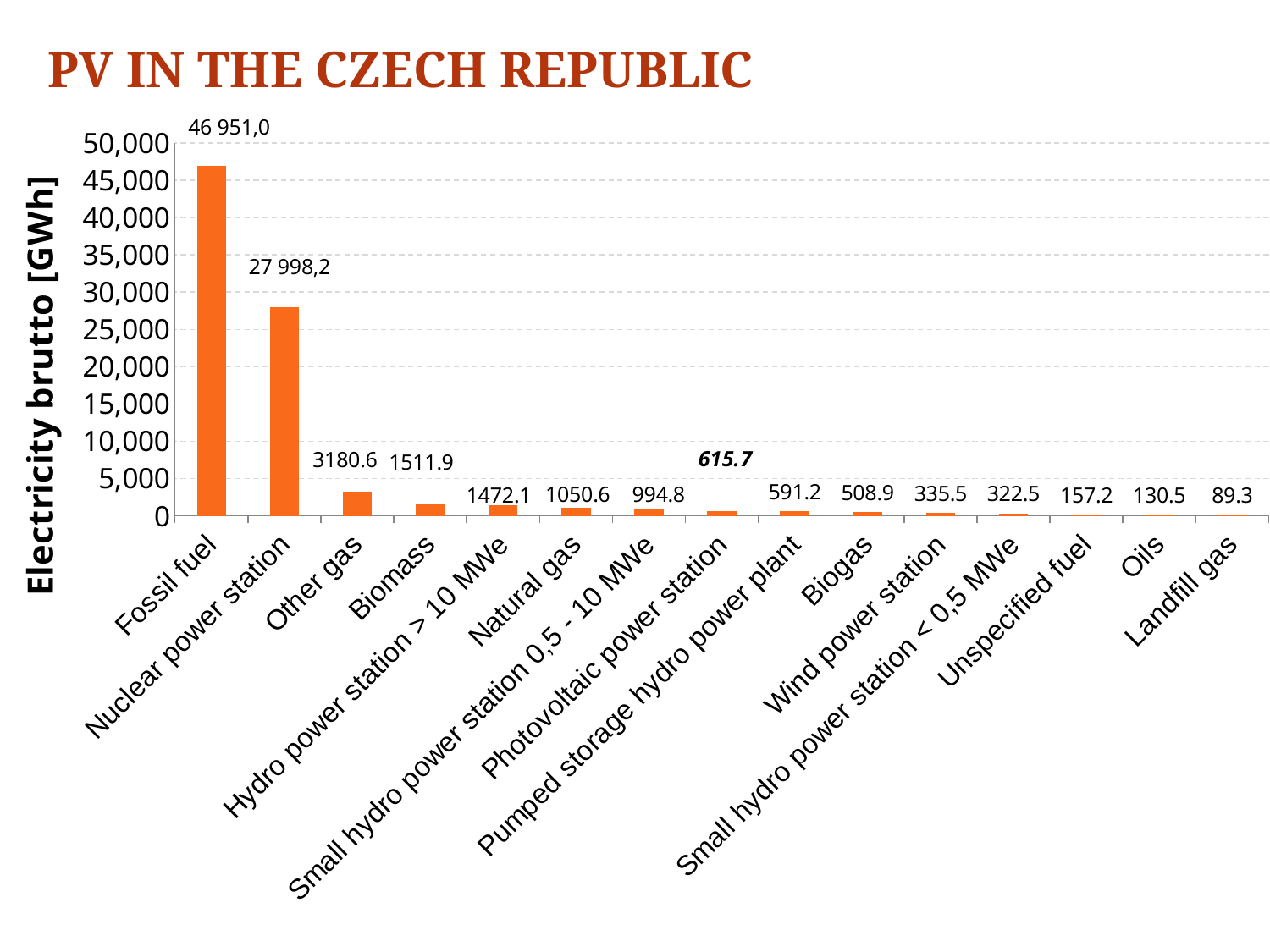
How many categories are shown on the x axis? 15 What is the difference between the values for Other gas and Biomass? 1668.7 Which category has the lowest value? Landfill gas What is the value for Fossil fuel? 46 951,0 Do the values rise or fall from left to right along the x axis? Fall Which category has the highest value? Fossil fuel Which is larger, the value for Natural gas or the value for Pumped storage hydro power plant? Natural gas What is the value for Landfill gas? 89.3 What kind of chart is shown on the slide? Bar chart What is the value for Biogas? 508.9 What is the difference between the values for Biogas and Wind power station? 173.4 What is the value for Photovoltaic power station? 615.7